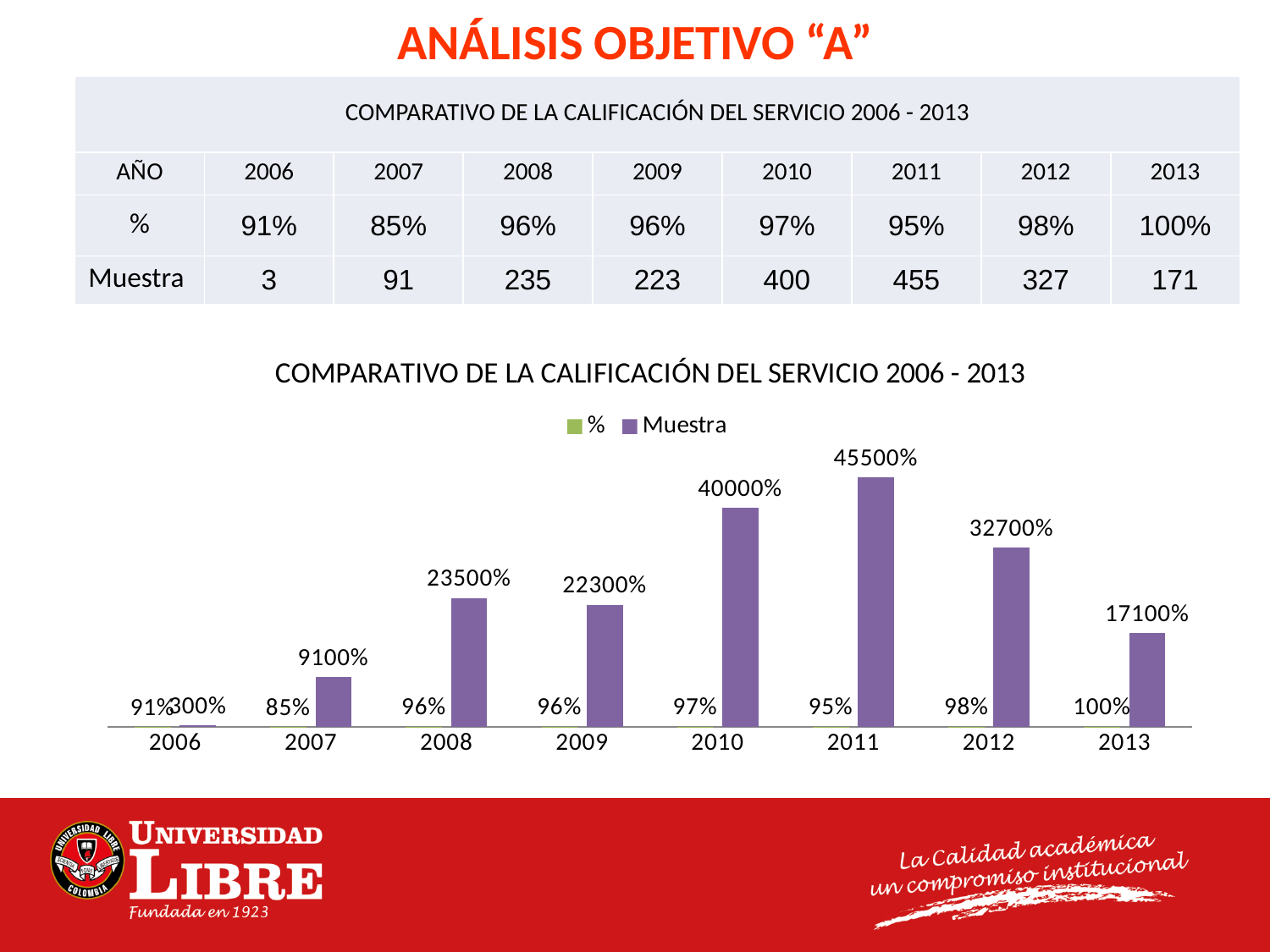
Is the Muestra bar for 2010 taller than the Muestra bar for 2012? Yes What is the data label for the % series in 2007? 85% Which series is shown in purple in the chart legend? Muestra What is the data label for the % series in 2013? 100% Which year has the lowest Muestra bar? 2006 How many years are shown on the x axis of the chart? 8 What type of chart is shown on the slide? bar chart Which year has the highest Muestra bar? 2011 What is the data label for the Muestra series in 2008? 23500% What is the title of the chart? COMPARATIVO DE LA CALIFICACIÓN DEL SERVICIO 2006 - 2013 How many series does the chart legend list? 2 What is the data label for the Muestra series in 2011? 45500%